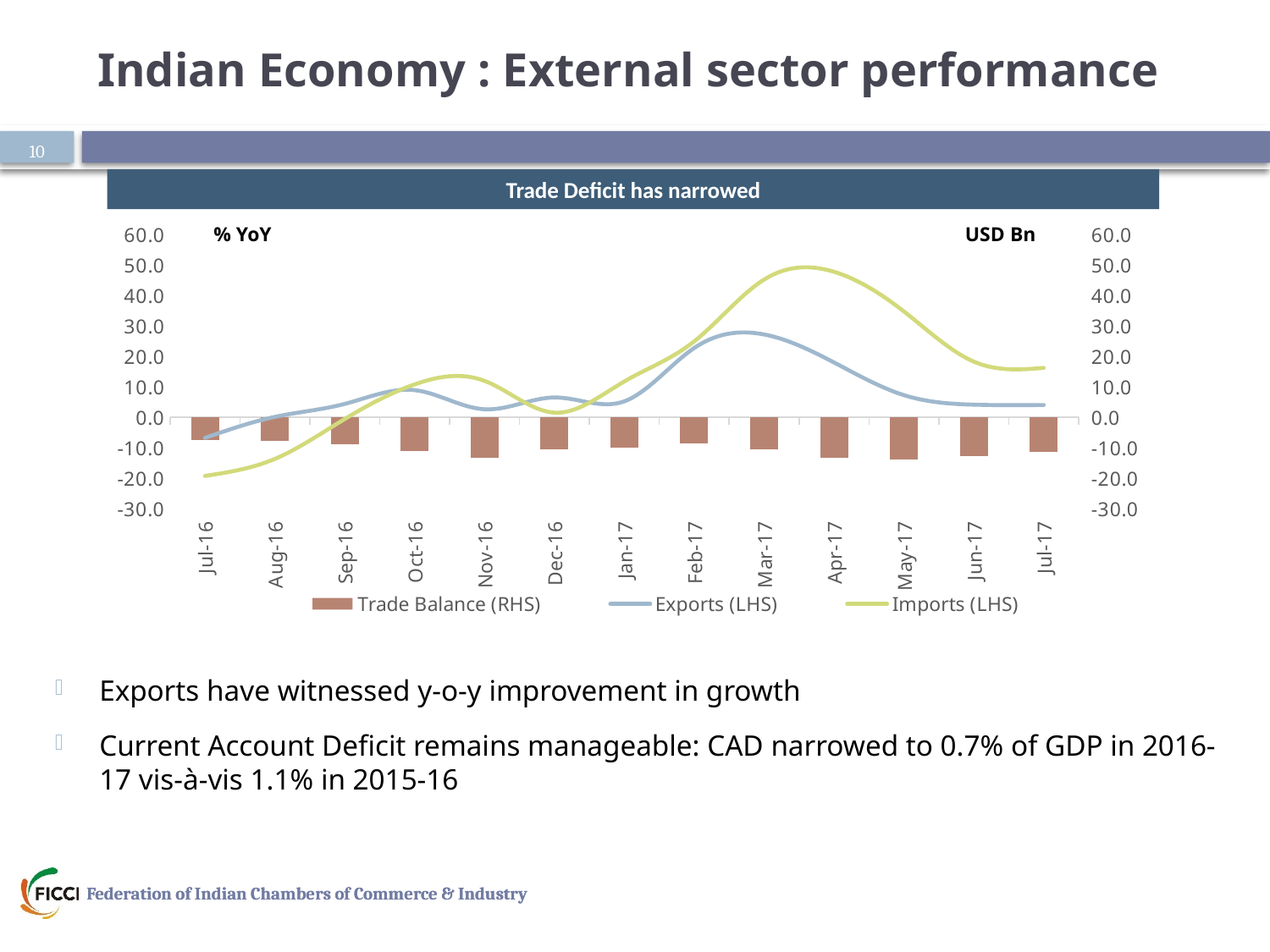
Is the Exports (LHS) value for Mar-17 greater or less than 20.0? greater In which month is the Imports (LHS) line at its lowest value? Jul-16 In which month does the Imports (LHS) line reach its highest value? Apr-17 In Mar-17, which is larger: Imports (LHS) or Exports (LHS)? Imports (LHS) How many months are shown on the x axis of the chart? 13 What is the title of the chart? Trade Deficit has narrowed Does the Imports (LHS) line rise or fall from Mar-17 to Jun-17? Fall What kind of chart is shown on the slide? A combination bar and line chart In which month does the Exports (LHS) line reach its highest value? Mar-17 Is the Imports (LHS) value for Jul-16 greater or less than -10.0? less How many series does the chart legend list? 3 Is the Imports (LHS) value for Mar-17 greater or less than 40.0? greater